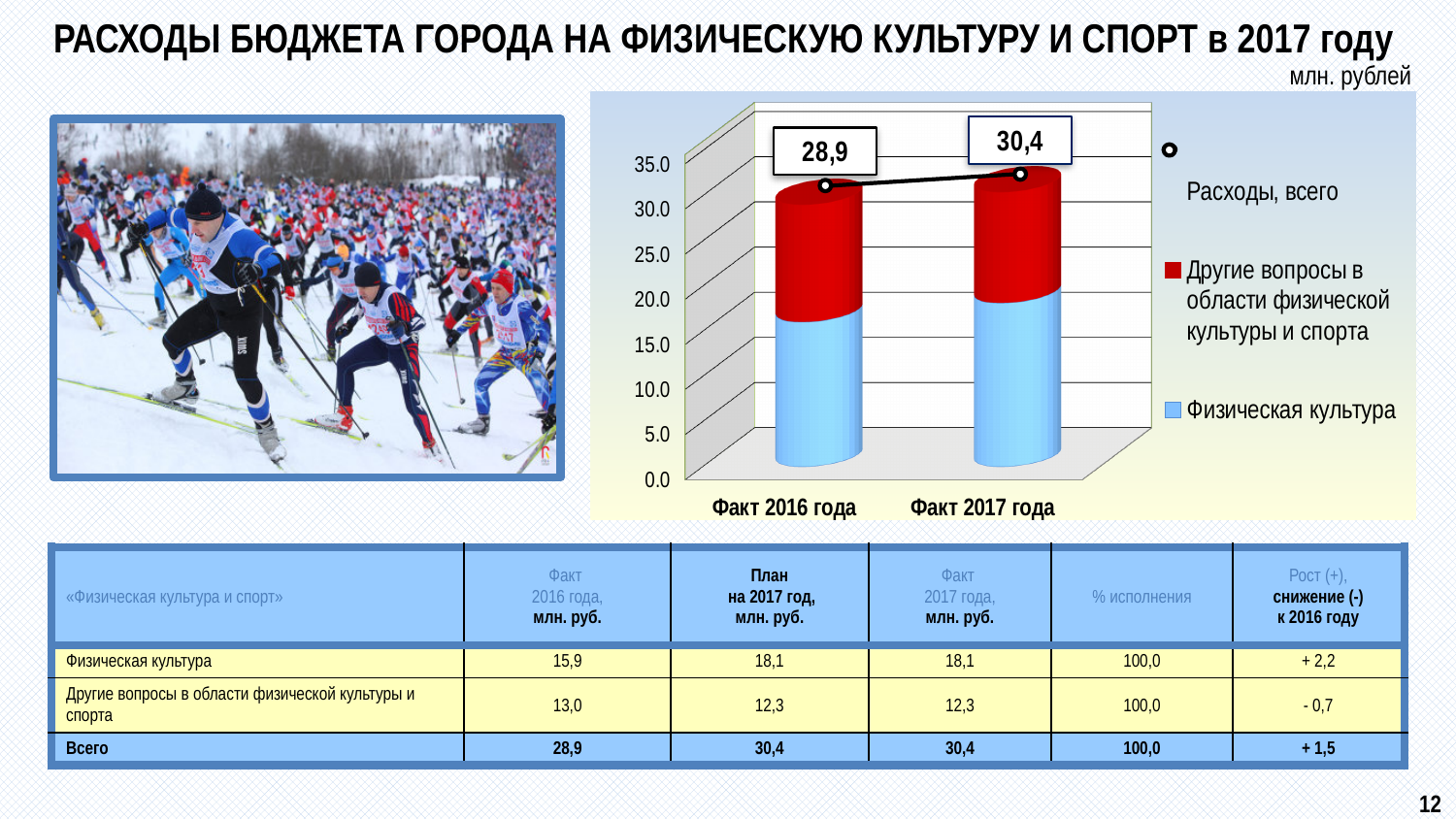
Do the total expenditures rise or fall from Факт 2016 года to Факт 2017 года? Rise Is the value of the Физическая культура segment for Факт 2016 года greater or less than 10.0? greater By how much does the total for Факт 2017 года exceed the total for Факт 2016 года? 1,5 What unit is stated above the chart? млн. рублей How many categories are shown on the x axis of the chart? 2 What is the total expenditure shown for Факт 2016 года? 28,9 Which legend entry is shown in red? Другие вопросы в области физической культуры и спорта Which category has the higher total, Факт 2016 года or Факт 2017 года? Факт 2017 года What is the total expenditure shown for Факт 2017 года? 30,4 How many entries does the chart legend list? 3 Is the value of the Физическая культура segment for Факт 2017 года greater or less than 15.0? greater What kind of chart is shown on the slide? Stacked bar chart with a line